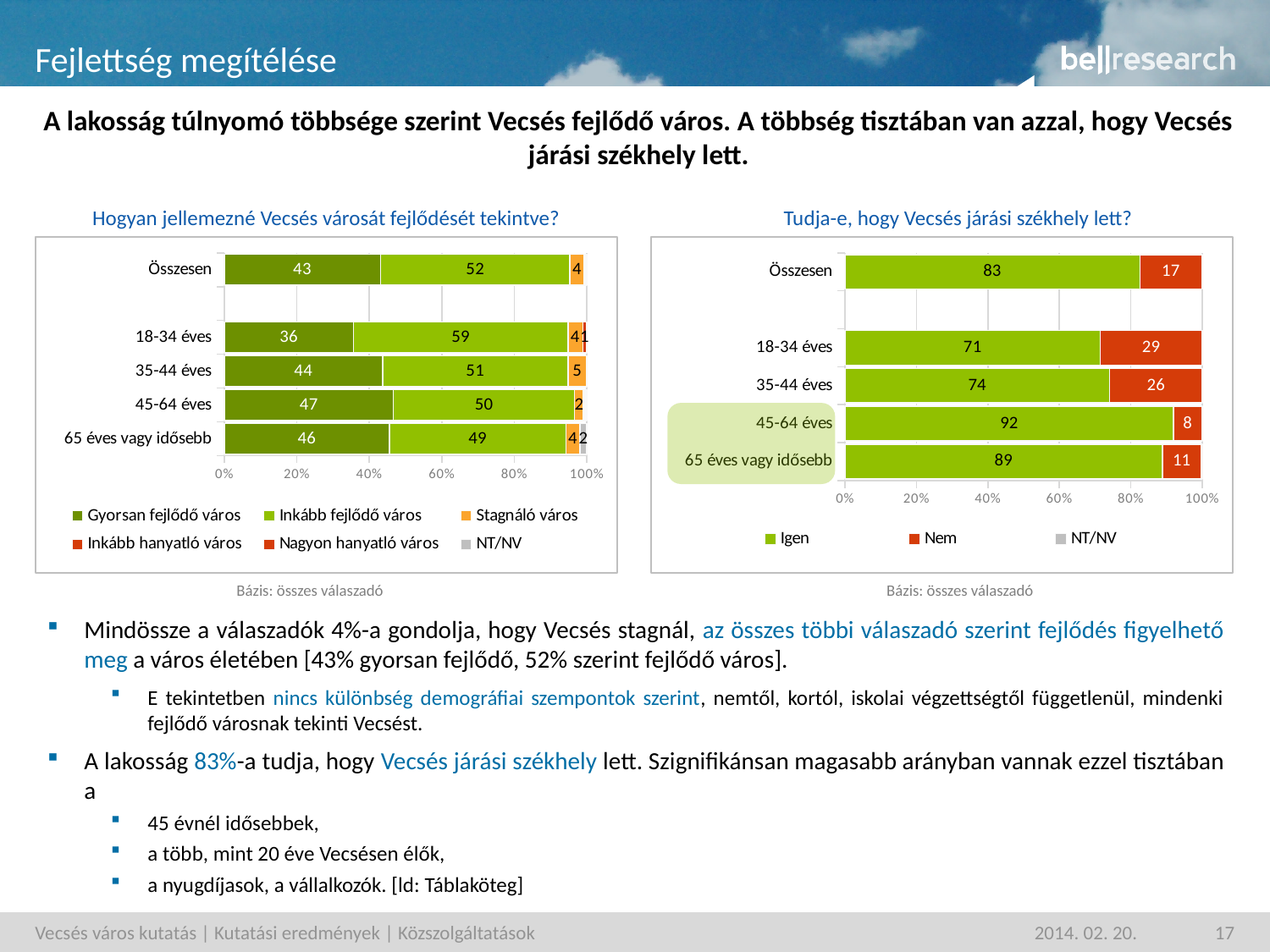
In the chart titled "Tudja-e, hogy Vecsés járási székhely lett?", what is the "Nem" value for 35-44 éves? 26 In the chart titled "Tudja-e, hogy Vecsés járási székhely lett?", which age group has the highest "Igen" value? 45-64 éves In the chart titled "Hogyan jellemezné Vecsés városát fejlődését tekintve?", is the "Gyorsan fejlődő város" value for 35-44 éves larger or smaller than that for 18-34 éves? larger In the chart titled "Hogyan jellemezné Vecsés városát fejlődését tekintve?", what is the "Gyorsan fejlődő város" value for Összesen? 43 In the chart titled "Tudja-e, hogy Vecsés járási székhely lett?", what is the value of "Igen" for Összesen? 83 In the chart titled "Hogyan jellemezné Vecsés városát fejlődését tekintve?", how many entries does the legend list? 6 In the chart titled "Hogyan jellemezné Vecsés városát fejlődését tekintve?", what is the "Inkább fejlődő város" value for 18-34 éves? 59 In the chart titled "Hogyan jellemezné Vecsés városát fejlődését tekintve?", which age group has the highest "Gyorsan fejlődő város" value? 45-64 éves In the chart titled "Tudja-e, hogy Vecsés járási székhely lett?", what is the difference between the "Igen" values for 45-64 éves and 18-34 éves? 21 In the chart titled "Tudja-e, hogy Vecsés járási székhely lett?", how many entries does the legend list? 3 What kind of chart is the chart titled "Hogyan jellemezné Vecsés városát fejlődését tekintve?"? Stacked bar chart In the chart titled "Tudja-e, hogy Vecsés járási székhely lett?", which age group has the lowest "Igen" value? 18-34 éves